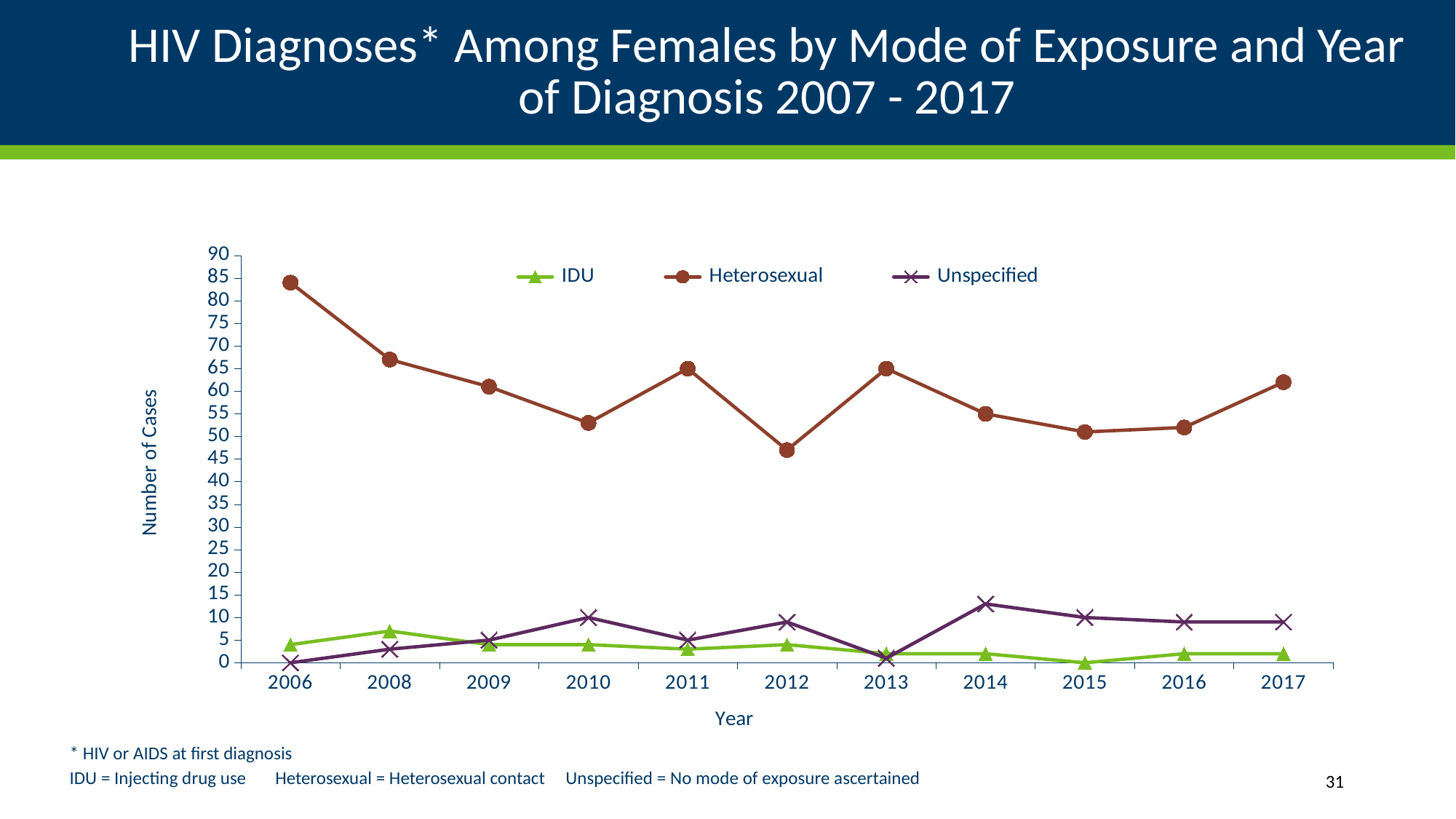
In which year is the Heterosexual series at its highest? 2006 What is the value for IDU in 2015? 0 How many years are plotted along the x axis? 11 Does the Heterosexual series rise or fall from 2006 to 2010? fall In which year is the Unspecified series at its highest? 2014 What kind of chart is shown on the slide? line chart What is the value for Unspecified in 2006? 0 How many series does the legend list? 3 Is the value for Heterosexual in 2012 greater or less than 50? less Is the value for Heterosexual in 2006 greater or less than 80? greater In which year is the Heterosexual series at its lowest? 2012 Which is larger in 2010, Heterosexual or IDU? Heterosexual